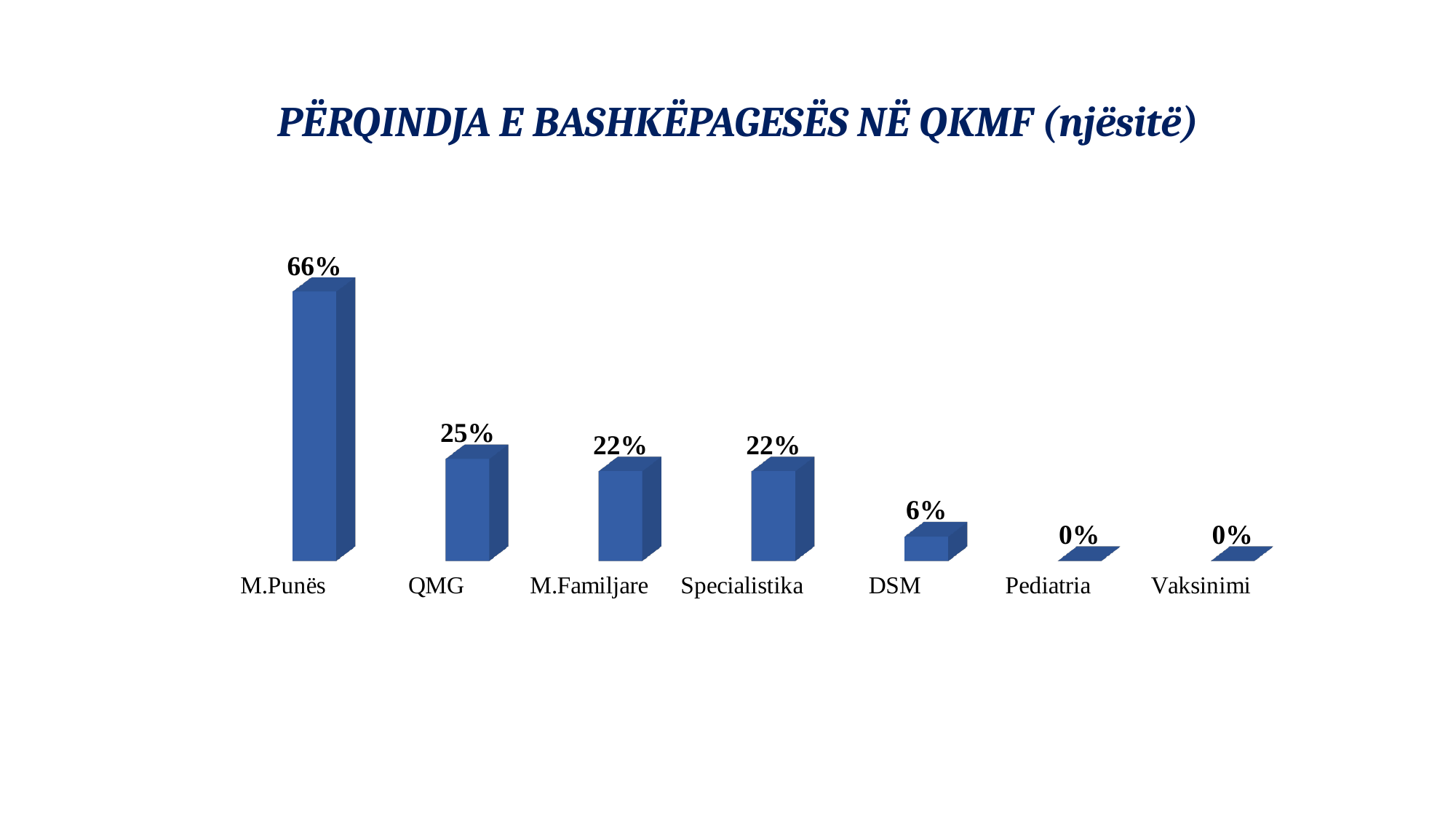
What is the value for Specialistika? 22% Which is larger, the value for QMG or the value for M.Familjare? QMG What is the value for M.Punës? 66% What is the difference between the values for QMG and DSM? 19% What is the title of the chart? PËRQINDJA E BASHKËPAGESËS NË QKMF (njësitë) What is the difference between the values for M.Punës and QMG? 41% What is the value for DSM? 6% What is the value for QMG? 25% How many categories are shown on the x axis? 7 Which category has the highest value? M.Punës What kind of chart is this? bar chart Do the values rise or fall from left to right along the x axis? fall